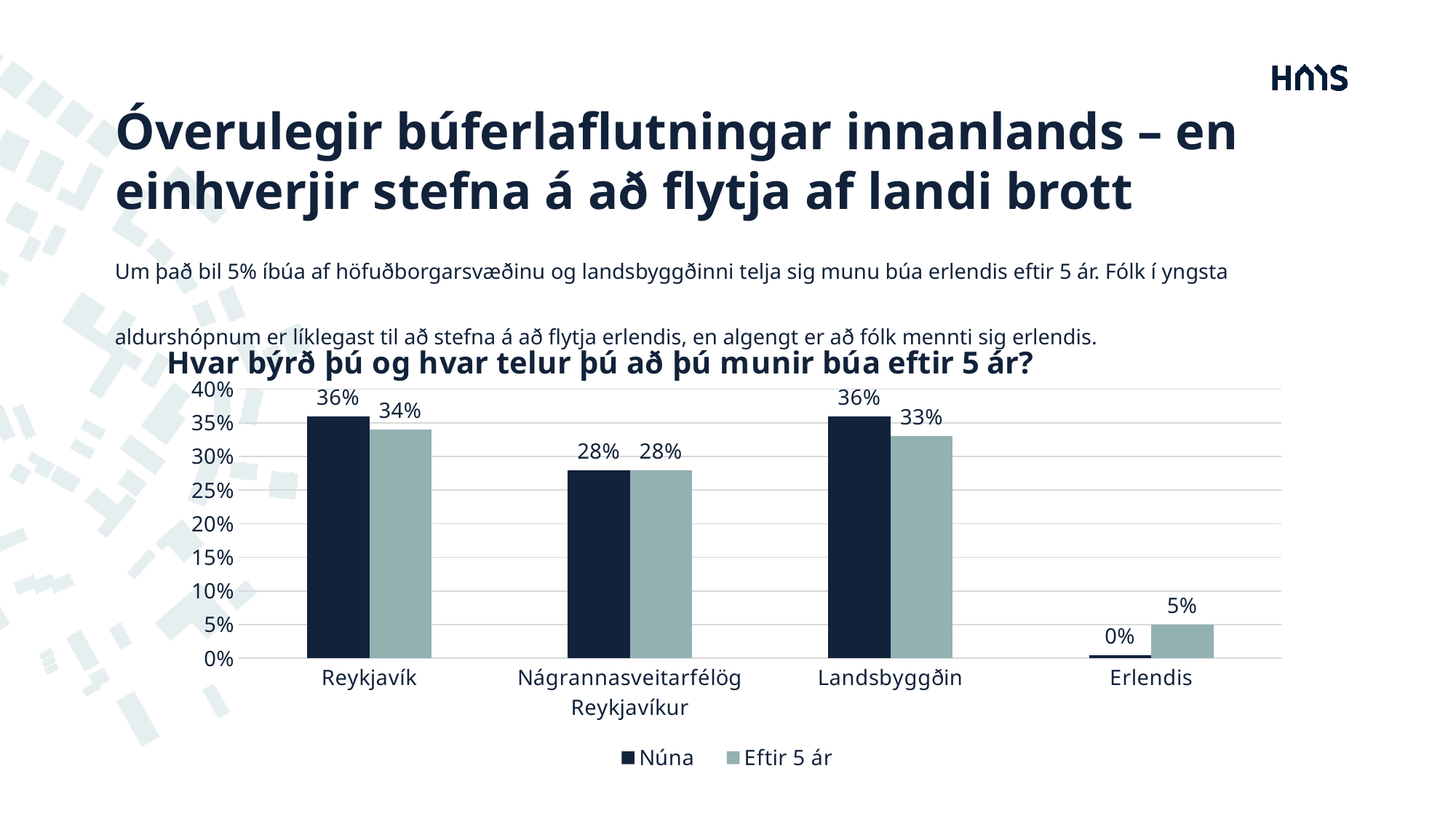
What is the title of the chart? Hvar býrð þú og hvar telur þú að þú munir búa eftir 5 ár? What is the value for Erlendis in the Eftir 5 ár series? 5% How many categories are shown on the x axis? 4 What is the difference between the Núna and Eftir 5 ár values for Landsbyggðin? 3% What is the value for Nágrannasveitarfélög Reykjavíkur in the Núna series? 28% What kind of chart is shown on the slide? Bar chart Which category has the highest value in the Eftir 5 ár series? Reykjavík Which is larger for Reykjavík: the Núna value or the Eftir 5 ár value? Núna What is the value for Landsbyggðin in the Eftir 5 ár series? 33% Which category has the lowest value in the Núna series? Erlendis How many series does the legend list? 2 What is the value for Reykjavík in the Núna series? 36%